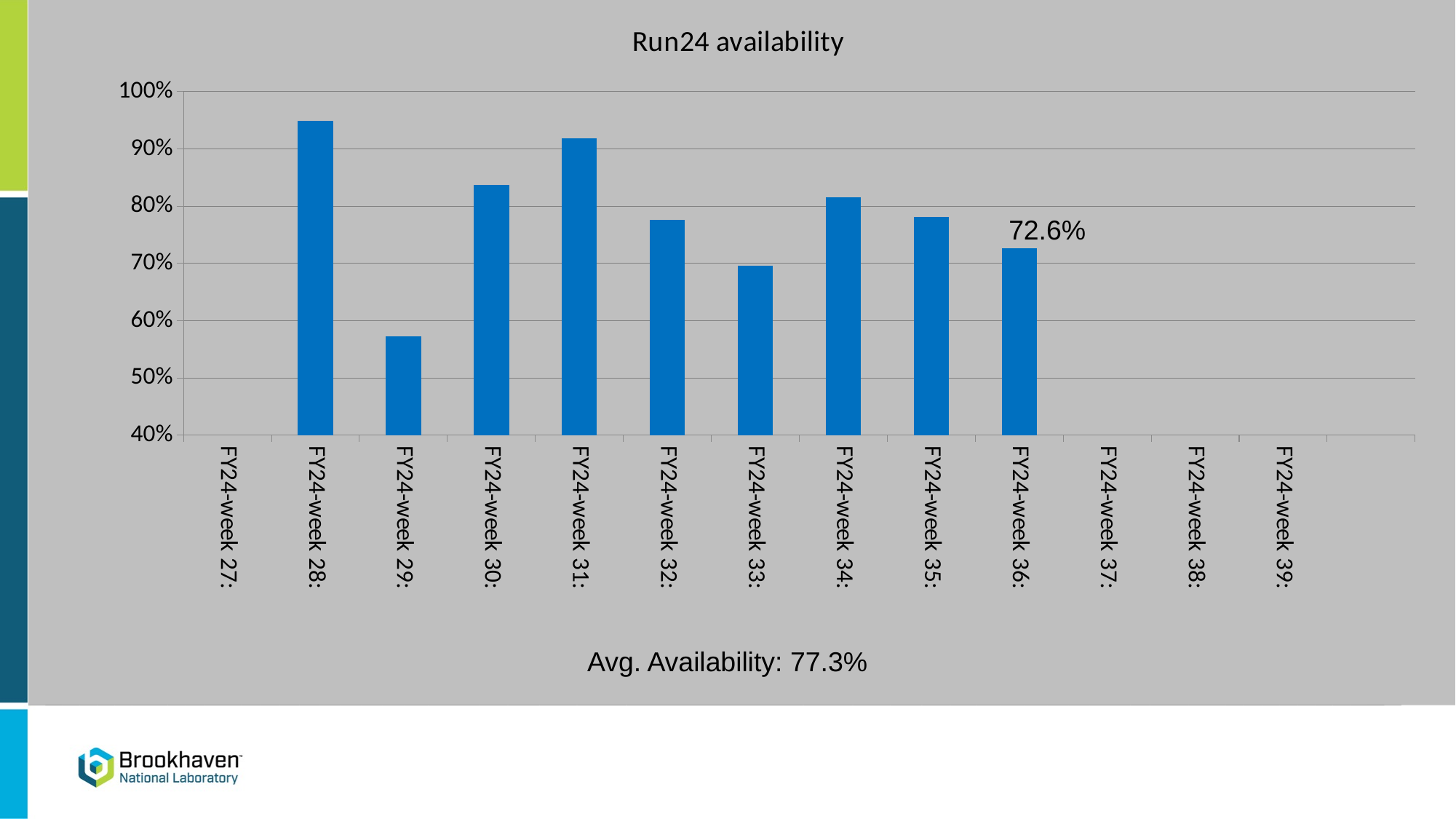
How many weeks have a bar plotted? 9 What kind of chart is shown on the slide? bar chart Is the value for FY24-week 30 greater or less than 80%? greater Is the value for FY24-week 29 greater or less than 60%? less Which week with a plotted bar has the lowest availability? FY24-week 29 What is the title of the chart? Run24 availability Which is larger, the availability for FY24-week 30 or FY24-week 32? FY24-week 30 Is the value for FY24-week 31 greater or less than 90%? greater Which week has the highest availability? FY24-week 28 What is the availability value shown for FY24-week 36? 72.6% How many week categories are labelled on the x axis? 13 What average availability is stated below the chart? 77.3%